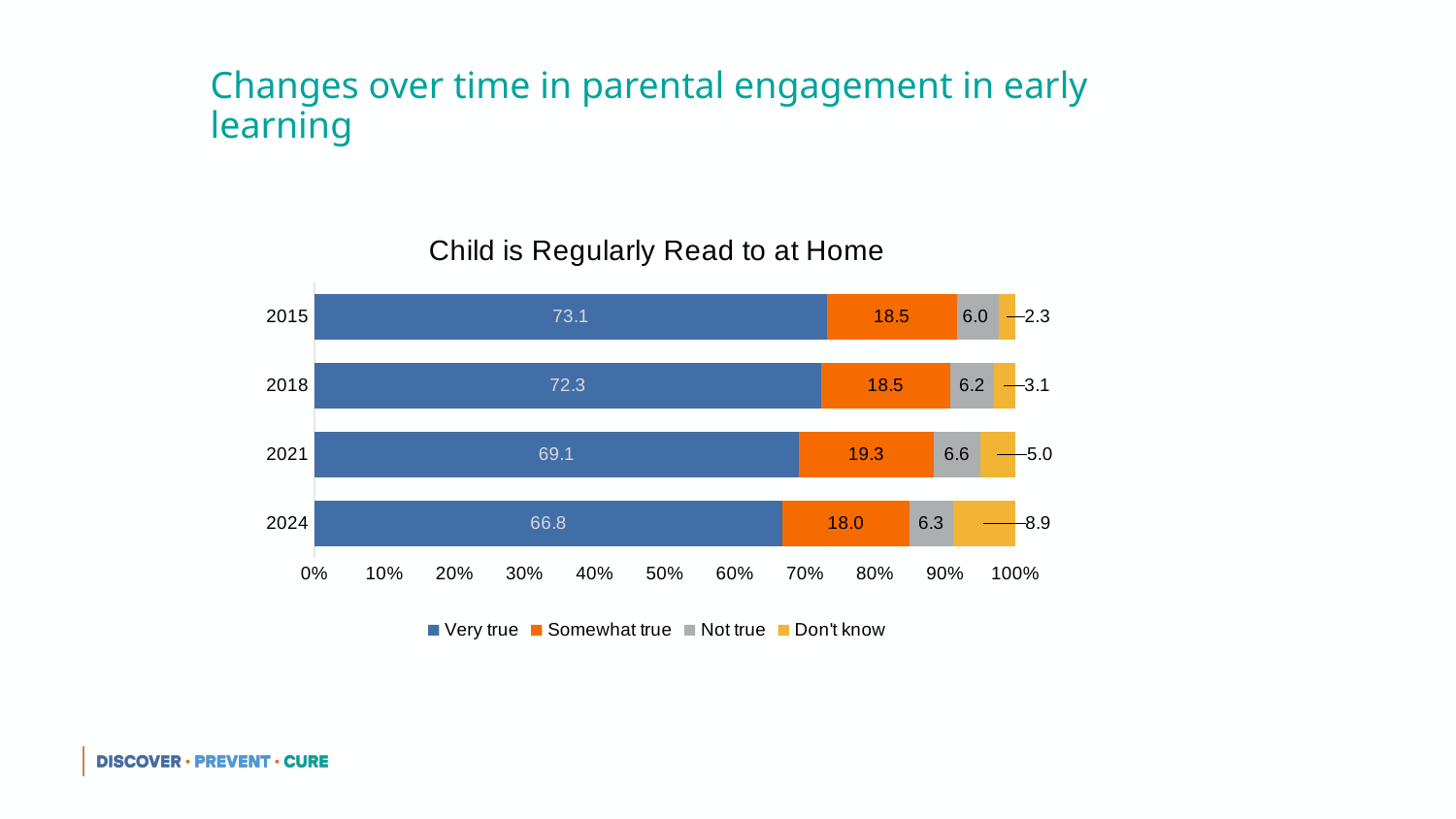
What is the "Very true" value for 2024? 66.8 How many series does the legend list? 4 What kind of chart is shown? Stacked bar chart What is the "Not true" value for 2018? 6.2 Which year has the highest "Very true" value? 2015 What is the "Don't know" value for 2015? 2.3 Does the "Very true" value rise or fall from 2015 to 2024? Fall What is the "Somewhat true" value for 2021? 19.3 Which is larger, the "Don't know" value for 2021 or for 2024? 2024 What is the difference between the "Very true" values for 2015 and 2024? 6.3 How many years are shown on the chart? 4 Which year has the lowest "Don't know" value? 2015